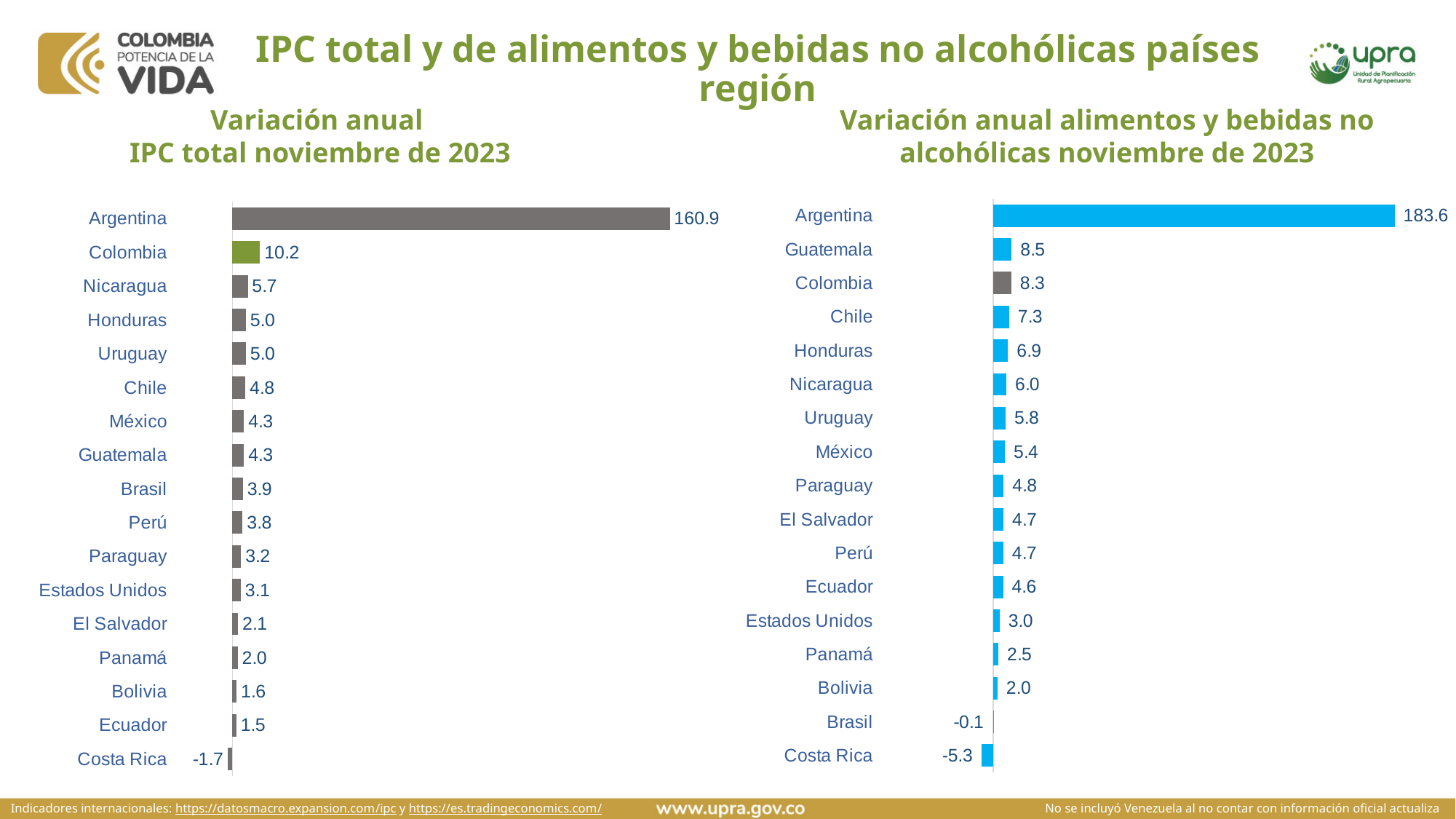
In the right chart (Variación anual alimentos y bebidas no alcohólicas noviembre de 2023), which is larger, the value for Chile or the value for Honduras? Chile In the left chart (Variación anual IPC total noviembre de 2023), which country has the lowest value? Costa Rica In the right chart (Variación anual alimentos y bebidas no alcohólicas noviembre de 2023), which country has the highest value? Argentina In the right chart (Variación anual alimentos y bebidas no alcohólicas noviembre de 2023), what is the difference between the values for Guatemala and Colombia? 0.2 In the left chart (Variación anual IPC total noviembre de 2023), which country has the highest value? Argentina In the right chart (Variación anual alimentos y bebidas no alcohólicas noviembre de 2023), what is the value for Costa Rica? -5.3 In the left chart (Variación anual IPC total noviembre de 2023), how many countries are shown? 17 In the left chart (Variación anual IPC total noviembre de 2023), what is the difference between the values for Argentina and Colombia? 150.7 In the left chart (Variación anual IPC total noviembre de 2023), what colour is the bar for Colombia? Green What kind of chart is the right chart (Variación anual alimentos y bebidas no alcohólicas noviembre de 2023)? Bar chart In the right chart (Variación anual alimentos y bebidas no alcohólicas noviembre de 2023), what is the value for Guatemala? 8.5 In the left chart (Variación anual IPC total noviembre de 2023), what is the value for Colombia? 10.2